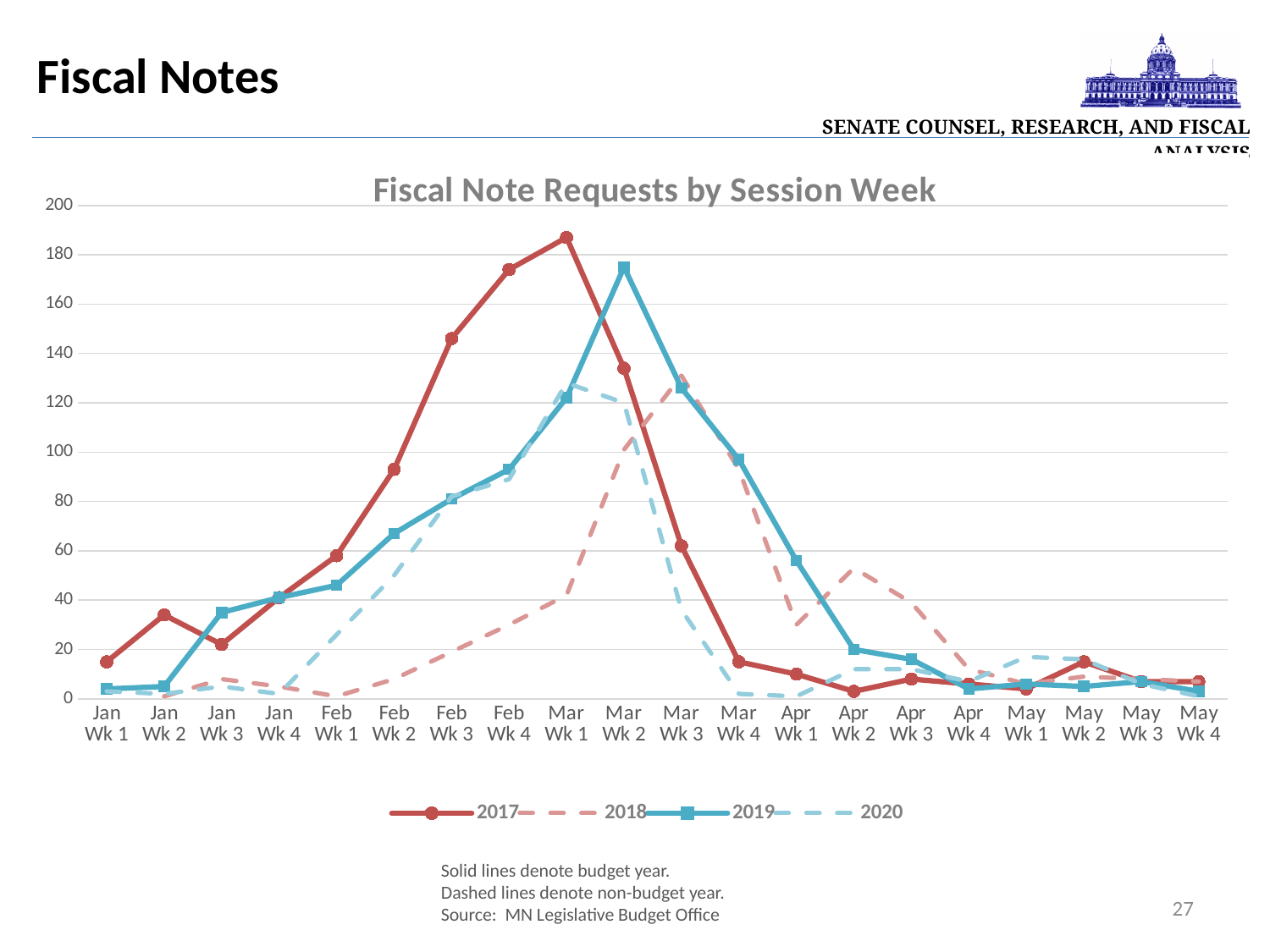
Does the 2019 series rise or fall from Mar Wk 2 to Apr Wk 2? fall In which session week does the 2019 series reach its highest value? Mar Wk 2 Which series has the larger value in Mar Wk 3, 2017 or 2019? 2019 Is the value for 2019 in Apr Wk 2 greater or less than 40? less How many session weeks are shown along the x axis? 20 Which series has the larger value in Mar Wk 1, 2017 or 2019? 2017 How many series does the legend list? 4 In which session week does the 2017 series reach its highest value? Mar Wk 1 Is the value for 2017 in Mar Wk 1 greater or less than 180? greater What is the title of the chart? Fiscal Note Requests by Session Week What kind of chart is shown on the slide? line chart Is the value for 2019 in Mar Wk 2 greater or less than 160? greater